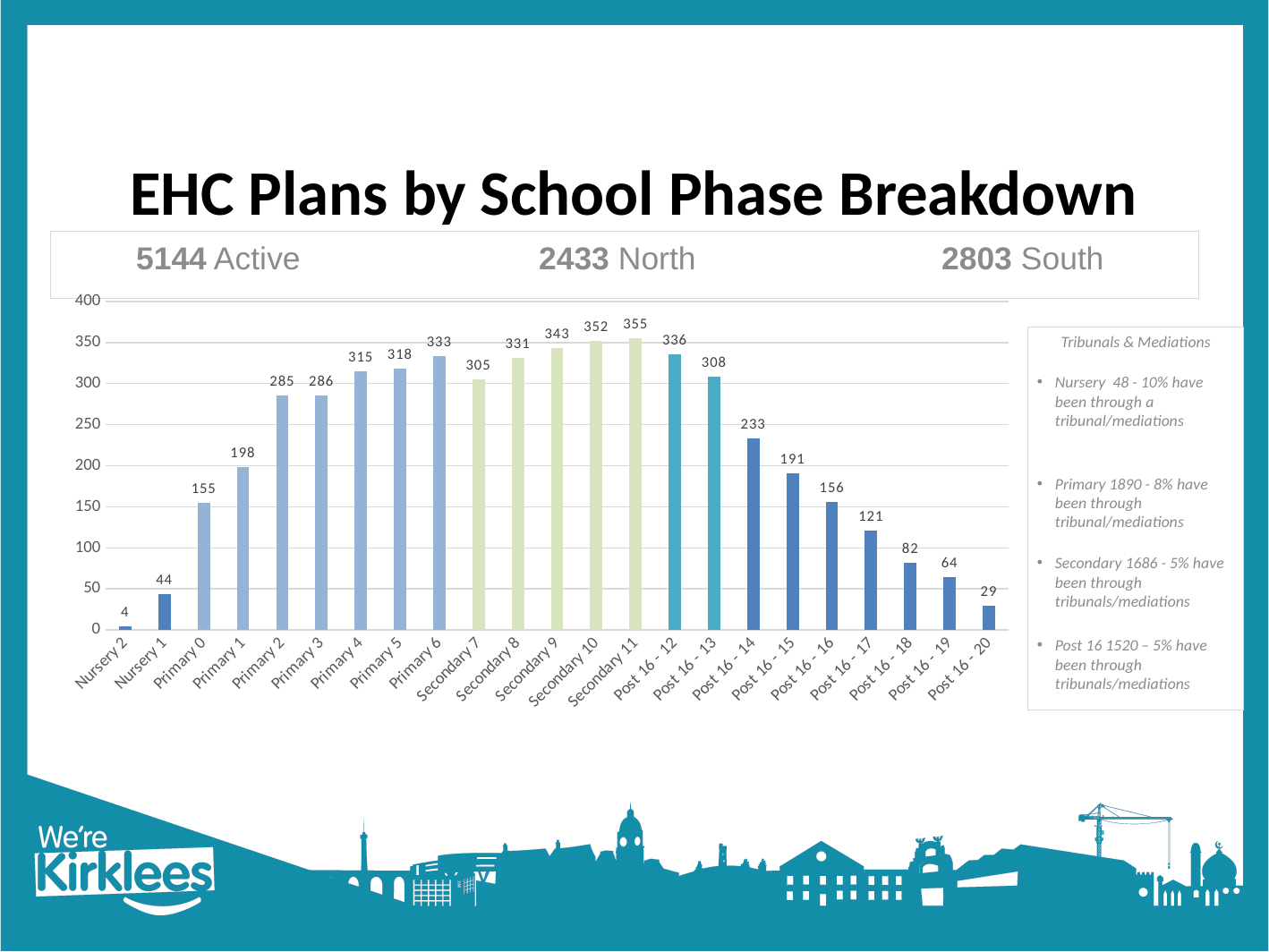
What is the value for Secondary 11? 355 Do the values rise or fall from Post 16 - 12 to Post 16 - 20? fall Which is larger, the value for Primary 6 or the value for Secondary 8? Primary 6 What is the value for Post 16 - 14? 233 What is the value for Primary 0? 155 Is the value for Post 16 - 17 greater or less than 150? less Which category has the highest value? Secondary 11 How many categories are shown on the x axis? 23 Which category has the lowest value? Nursery 2 What kind of chart is shown on the slide? bar chart What is the difference between the values for Post 16 - 12 and Post 16 - 13? 28 What is the title of the slide containing the chart? EHC Plans by School Phase Breakdown